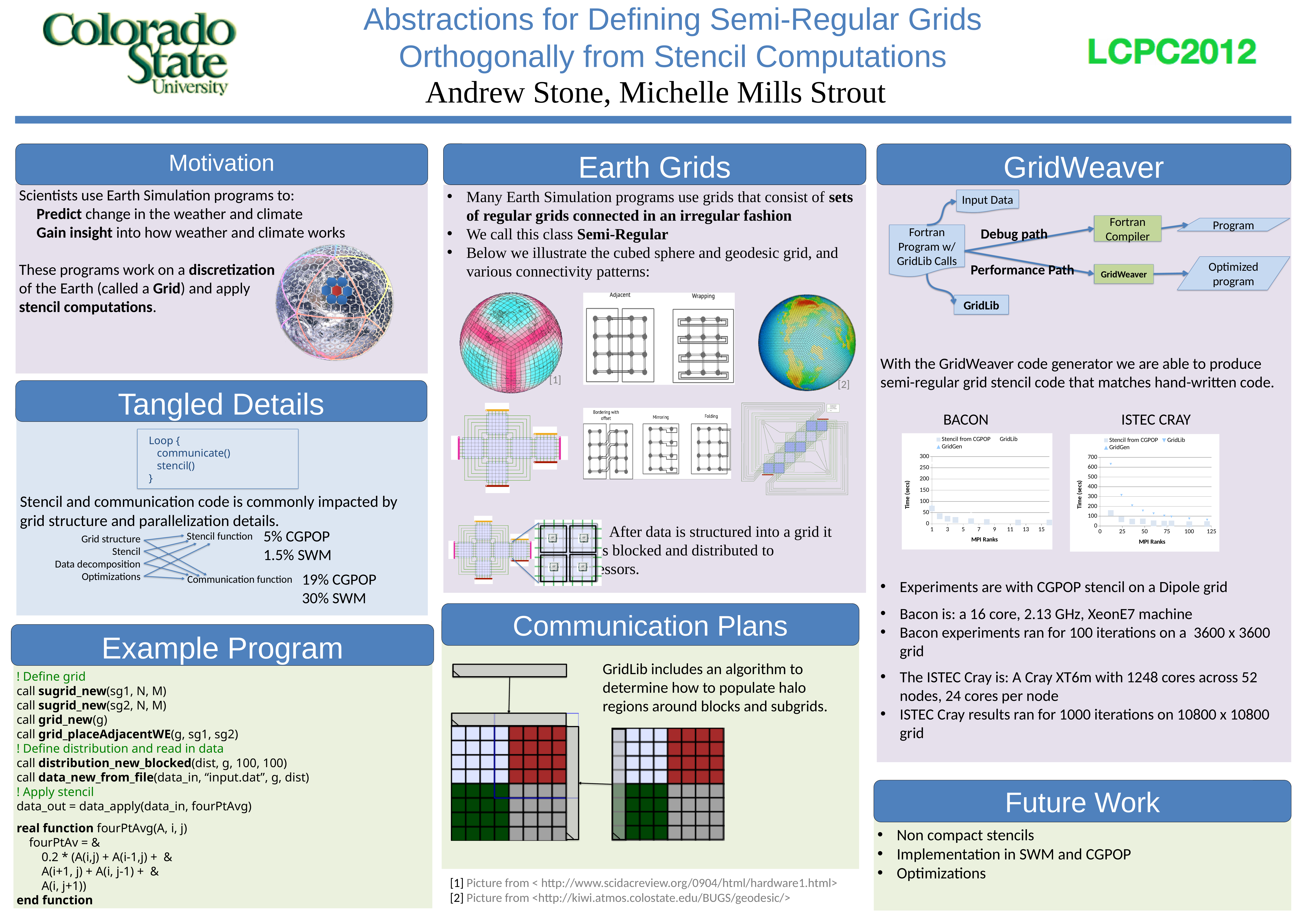
What kind of chart is the BACON chart? scatter chart In the BACON chart, what is the highest tick value shown on the y-axis? 300 In the BACON chart, how many series does the legend list? 3 In the ISTEC CRAY chart, is the highest plotted time value greater or less than 500 seconds? greater In the ISTEC CRAY chart, what is the largest MPI Ranks tick shown on the x-axis? 125 In the ISTEC CRAY chart, do the times generally rise or fall as MPI Ranks increase? fall In the ISTEC CRAY chart, how many series does the legend list? 3 What are the titles of the two charts in the GridWeaver section? BACON and ISTEC CRAY In the ISTEC CRAY chart, what is the highest tick value shown on the y-axis? 700 In the BACON chart, do the times generally rise or fall as MPI Ranks increase? fall What is the y-axis label of the ISTEC CRAY chart? Time (secs)